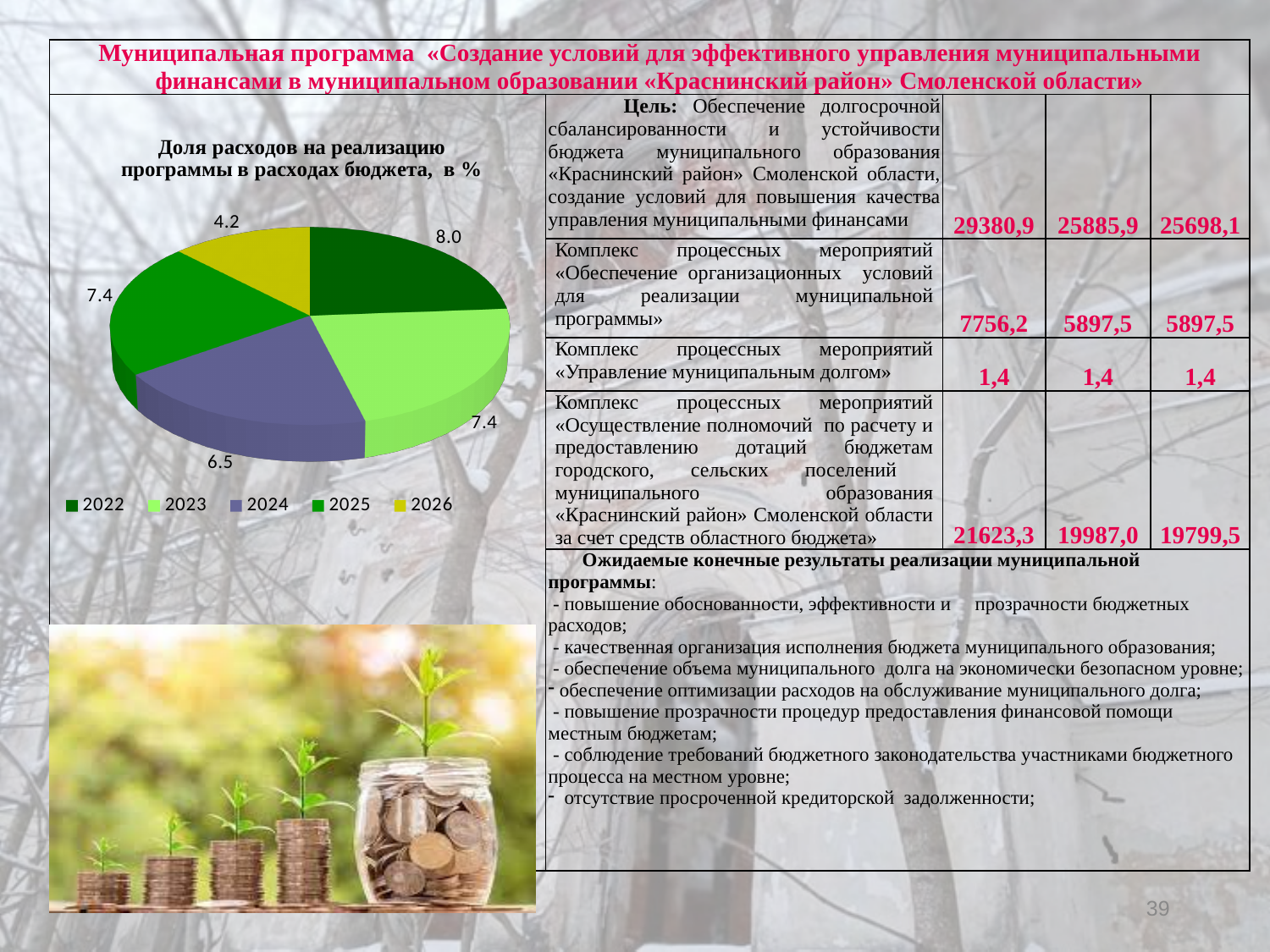
What value is shown for 2026 in the pie chart? 4.2 What is the title of the pie chart? Доля расходов на реализацию программы в расходах бюджета, в % What is the difference between the values for 2022 and 2026 in the pie chart? 3.8 What value is shown for 2023 in the pie chart? 7.4 What value is shown for 2022 in the pie chart? 8.0 What value is shown for 2024 in the pie chart? 6.5 How many years does the legend of the pie chart list? 5 Which is larger in the pie chart, the value for 2024 or the value for 2025? 2025 How many slices does the pie chart have? 5 Which year has the largest share in the pie chart? 2022 Which year has the smallest share in the pie chart? 2026 What type of chart is shown on the slide? pie chart